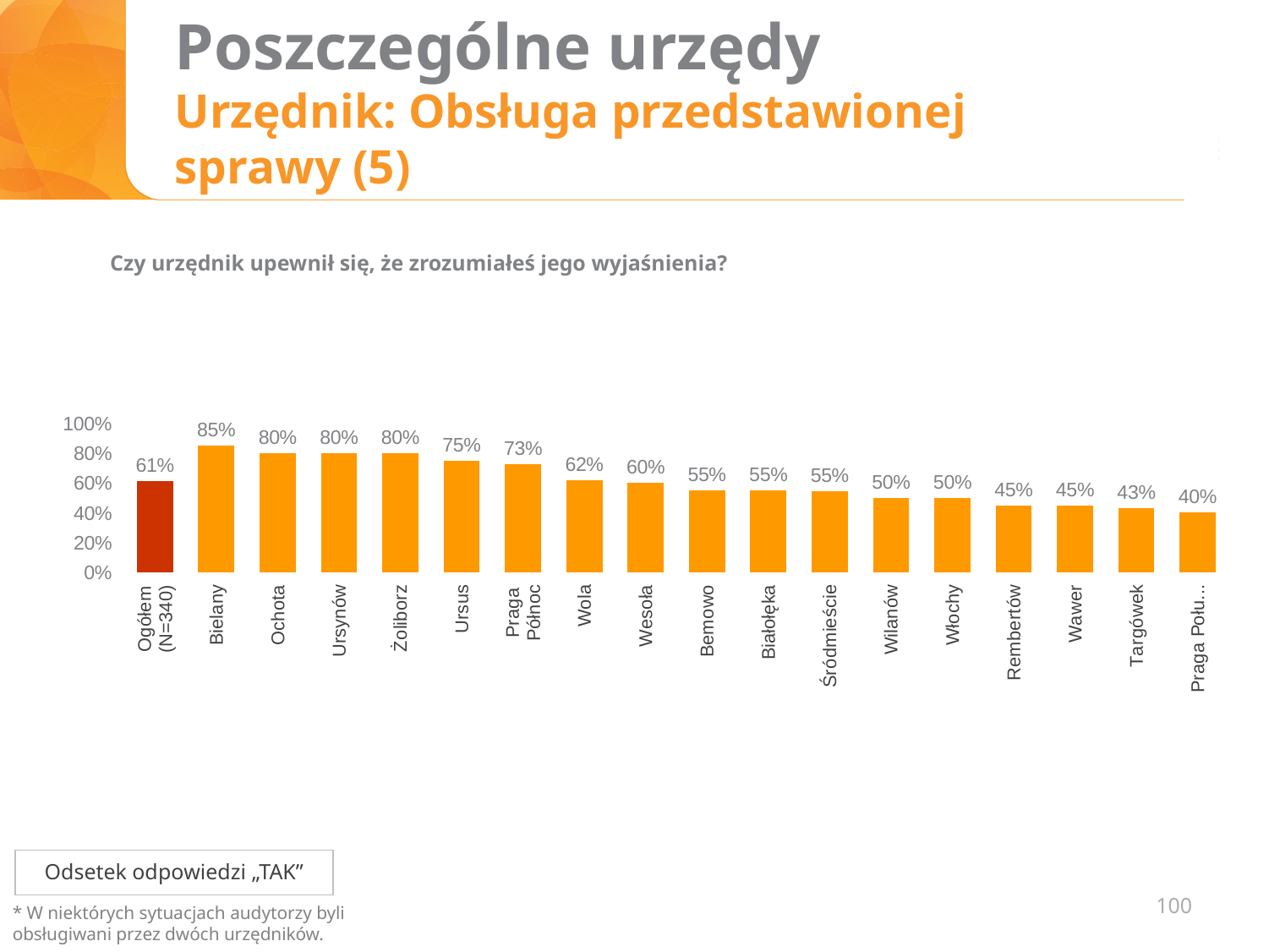
Which bar is shown in a different colour (dark red) from the others? Ogółem (N=340) What is the value for Ogółem (N=340)? 61% Which category has the lowest value? Praga Połu... What is the difference between the values for Bielany and Ursus? 10% Is the value for Praga Północ greater or less than 60%? greater What is the value for Bielany? 85% Which is larger, the value for Wesoła or the value for Bemowo? Wesoła What kind of chart is shown on the slide? bar chart What is the value for Wola? 62% How many bars are shown in the chart? 18 Which district has the highest value? Bielany What is the value for Targówek? 43%